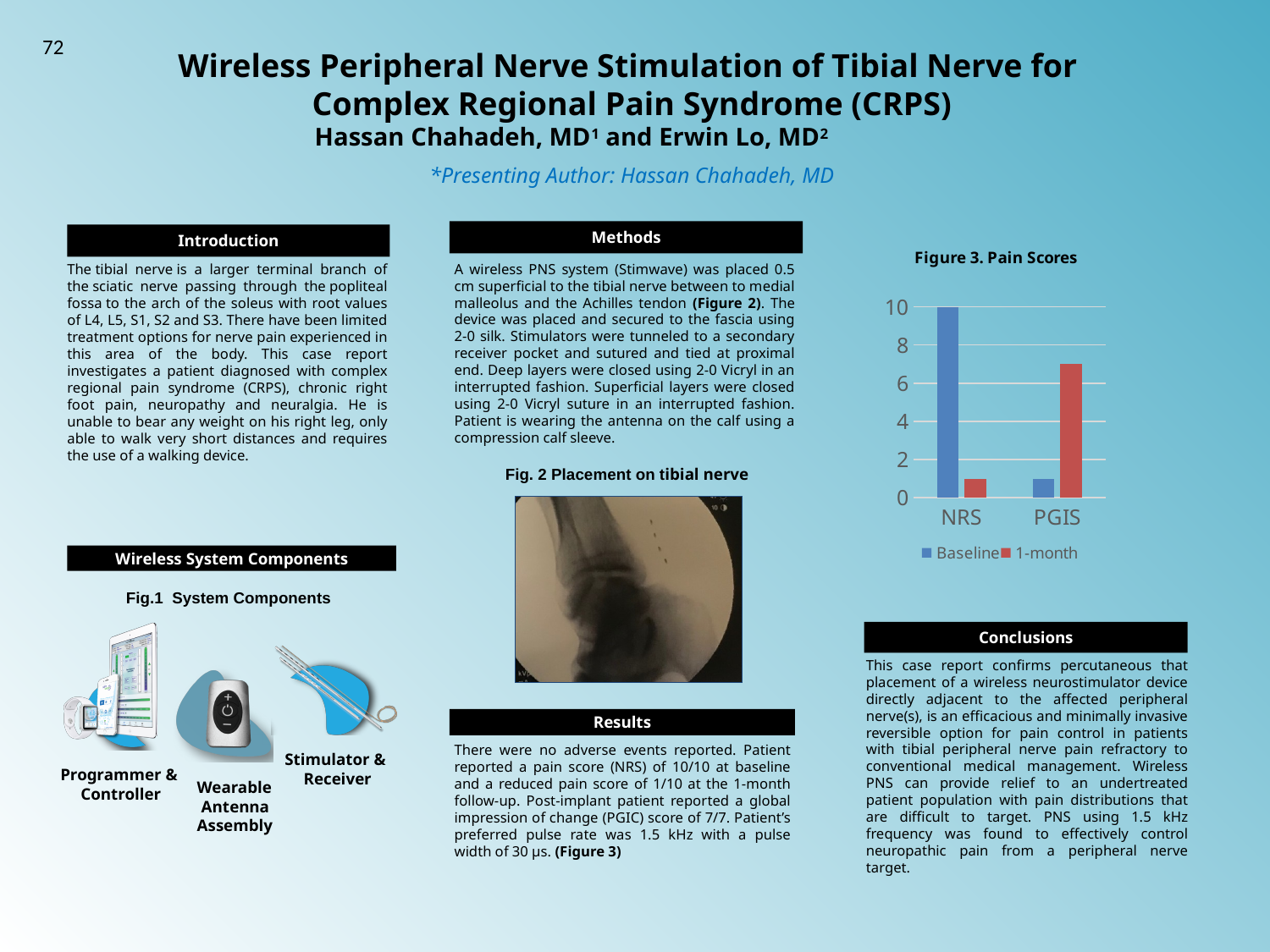
What is the title of the chart on the slide? Figure 3. Pain Scores In the Pain Scores chart, which is larger for PGIS: the Baseline value or the 1-month value? 1-month How many series does the legend of the Pain Scores chart list? 2 In the Pain Scores chart, is the Baseline value for PGIS greater or less than 2? less What kind of chart is Figure 3. Pain Scores? bar chart How many categories are shown on the x axis of the Pain Scores chart? 2 In the Pain Scores chart, what colour represents the 1-month series? red In the Pain Scores chart, is the 1-month value for NRS greater or less than 2? less In the Pain Scores chart, is the 1-month value for PGIS greater or less than 6? greater In the Pain Scores chart, which is larger for NRS: the Baseline value or the 1-month value? Baseline In the Pain Scores chart, what is the Baseline value for NRS? 10 In the Pain Scores chart, which category has the higher Baseline value? NRS